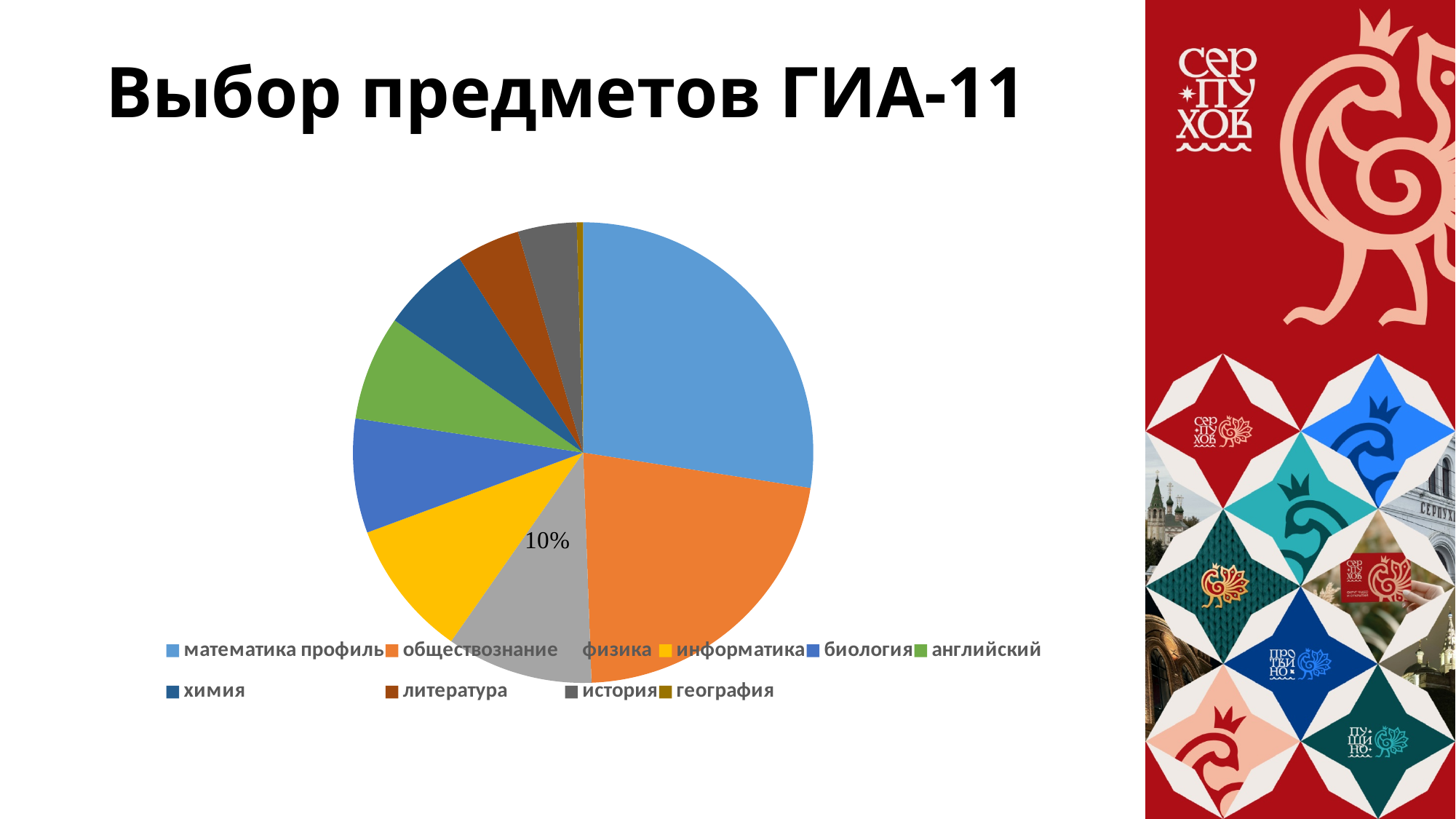
Which slice is larger, английский or литература? английский What colour is the slice for информатика? yellow Which slice is larger, информатика or география? информатика Which subject has the smallest slice of the pie? география What share of the pie does физика have? 10% What kind of chart is shown on the slide? pie chart Which slice is larger, биология or история? биология What is the title of the chart? Выбор предметов ГИА-11 Which subject has the largest slice of the pie? математика профиль How many subjects are shown in the pie chart? 10